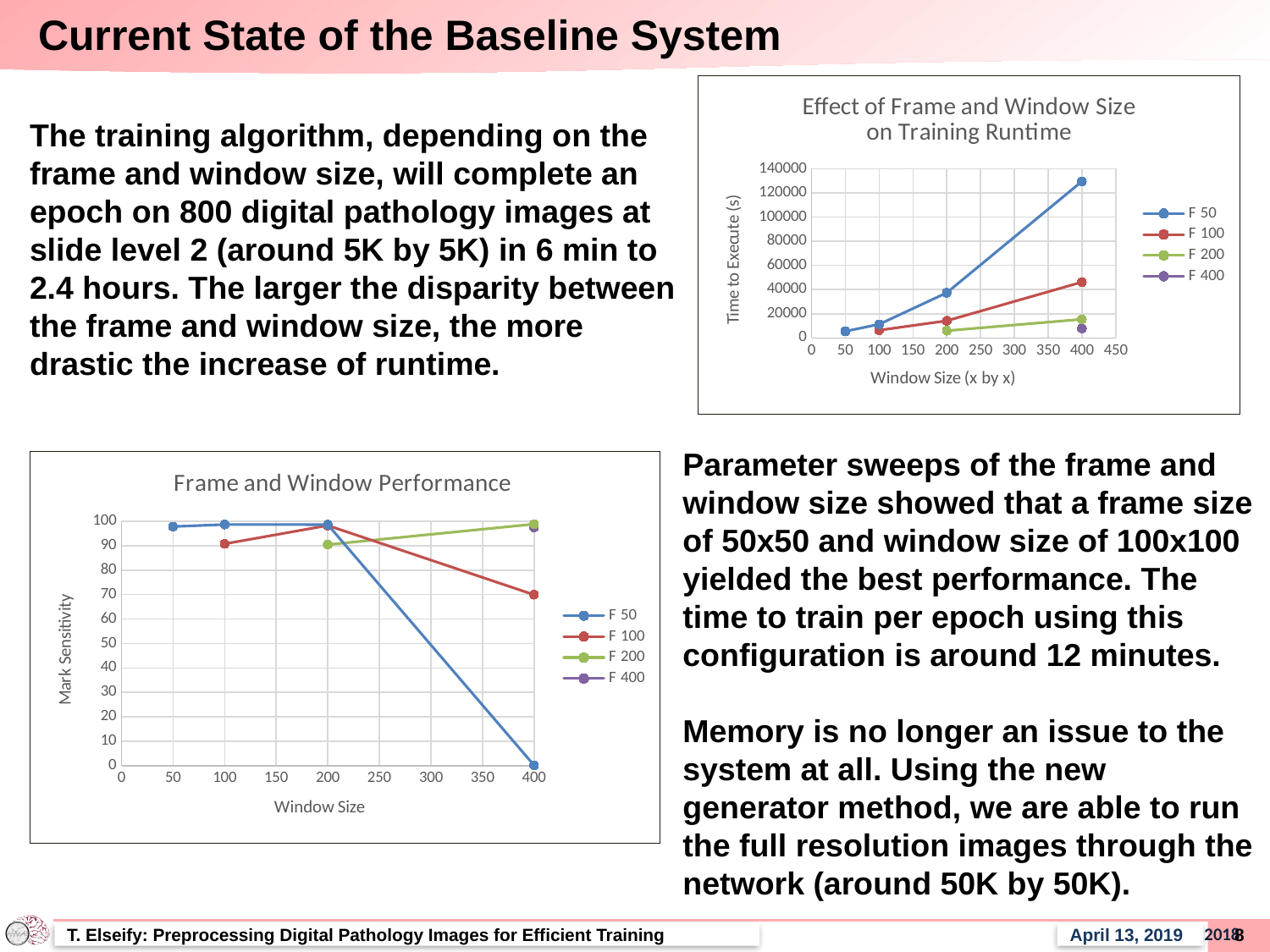
In the 'Effect of Frame and Window Size on Training Runtime' chart, which series has the highest time to execute at window size 400? F 50 In the 'Effect of Frame and Window Size on Training Runtime' chart, does the F 50 series rise or fall as window size increases? rise In the 'Frame and Window Performance' chart, is the mark sensitivity for F 100 at window size 400 greater or less than 80? less How many series does the legend of the 'Effect of Frame and Window Size on Training Runtime' chart list? 4 In the 'Frame and Window Performance' chart, which series has the lowest mark sensitivity at window size 400? F 50 What kind of chart is the 'Frame and Window Performance' chart? line chart In the 'Effect of Frame and Window Size on Training Runtime' chart, is the time to execute for F 50 at window size 400 greater or less than 120000? greater What is the y-axis label of the 'Effect of Frame and Window Size on Training Runtime' chart? Time to Execute (s) In the 'Effect of Frame and Window Size on Training Runtime' chart, is the time to execute for F 100 at window size 400 greater or less than 60000? less In the 'Frame and Window Performance' chart, does the F 50 series rise or fall between window size 200 and 400? fall In the 'Frame and Window Performance' chart, what is the mark sensitivity for F 50 at window size 400? 0 What kind of chart is the 'Effect of Frame and Window Size on Training Runtime' chart? line chart